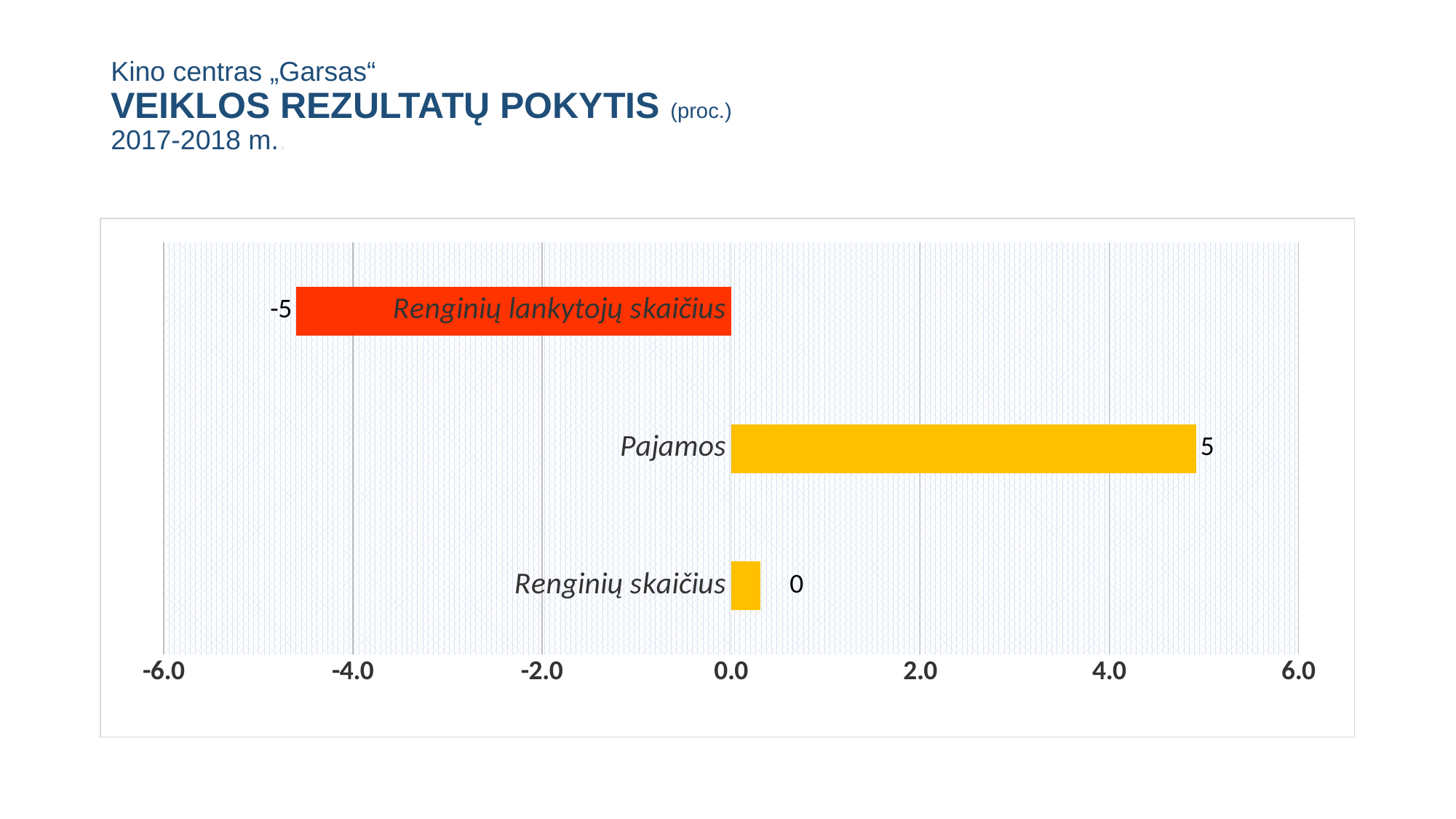
What is the data label shown for Pajamos? 5 Is the value for Renginių lankytojų skaičius greater or less than -4.0? less What period does the slide title say the change covers? 2017-2018 m. What is the data label shown for Renginių lankytojų skaičius? -5 What is the data label shown for Renginių skaičius? 0 How many categories are shown in the chart? 3 Is the value for Renginių skaičius greater or less than 2.0? less Which is larger, the value for Pajamos or the value for Renginių skaičius? Pajamos Which category has the lowest value? Renginių lankytojų skaičius Which category has the highest value? Pajamos What kind of chart is shown on the slide? Bar chart Is the value for Pajamos greater or less than 4.0? greater